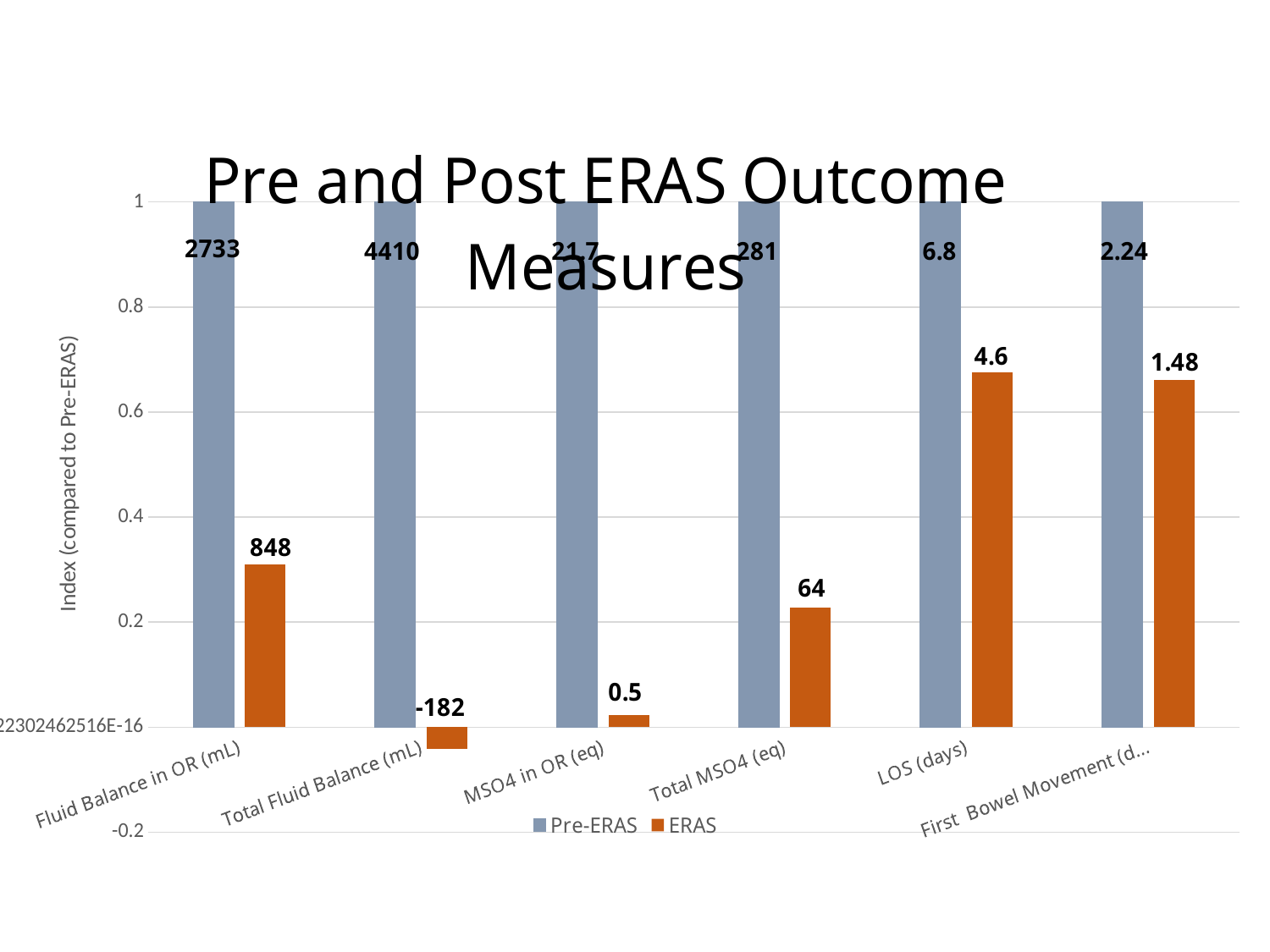
What data label is shown on the ERAS bar for Total Fluid Balance (mL)? -182 What is the title of the chart? Pre and Post ERAS Outcome Measures What is the difference between the Pre-ERAS and ERAS data labels for LOS (days)? 2.2 Which category has the lowest ERAS bar? Total Fluid Balance (mL) How many series does the legend list? 2 Which ERAS bar is taller: Fluid Balance in OR (mL) or MSO4 in OR (eq)? Fluid Balance in OR (mL) Is the ERAS bar for Fluid Balance in OR (mL) greater or less than 0.2 on the index axis? greater What data label is shown on the ERAS bar for LOS (days)? 4.6 What data label is shown on the ERAS bar for Total MSO4 (eq)? 64 What data label is shown on the Pre-ERAS bar for Fluid Balance in OR (mL)? 2733 What type of chart is shown on the slide? bar chart How many categories are shown on the x axis? 6